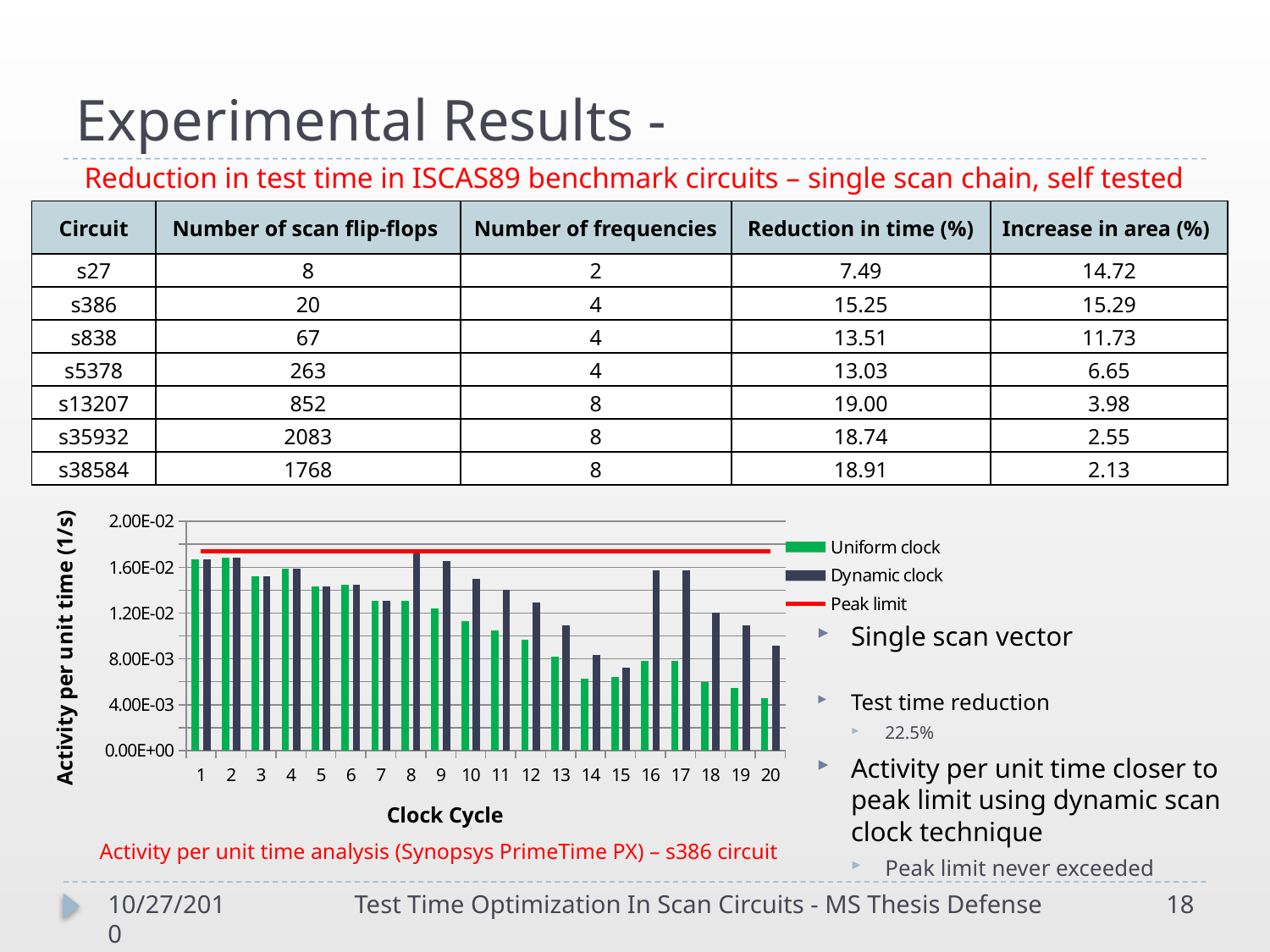
What kind of chart is shown on the slide? combination bar and line chart At which clock cycle is the Uniform clock value lowest? 20 What is the title of the chart's x axis? Clock Cycle Is the Uniform clock value at clock cycle 12 greater or less than 8.00E-03? greater At clock cycle 16, which series has the larger value, Uniform clock or Dynamic clock? Dynamic clock How many clock cycles are plotted along the x axis of the chart? 20 Is the Dynamic clock value at clock cycle 8 greater or less than 1.60E-02? greater Is the Uniform clock value at clock cycle 14 greater or less than 8.00E-03? less Do the Uniform clock values generally rise or fall as the clock cycle increases? fall What is the title of the chart's y axis? Activity per unit time (1/s) How many entries does the chart's legend list? 3